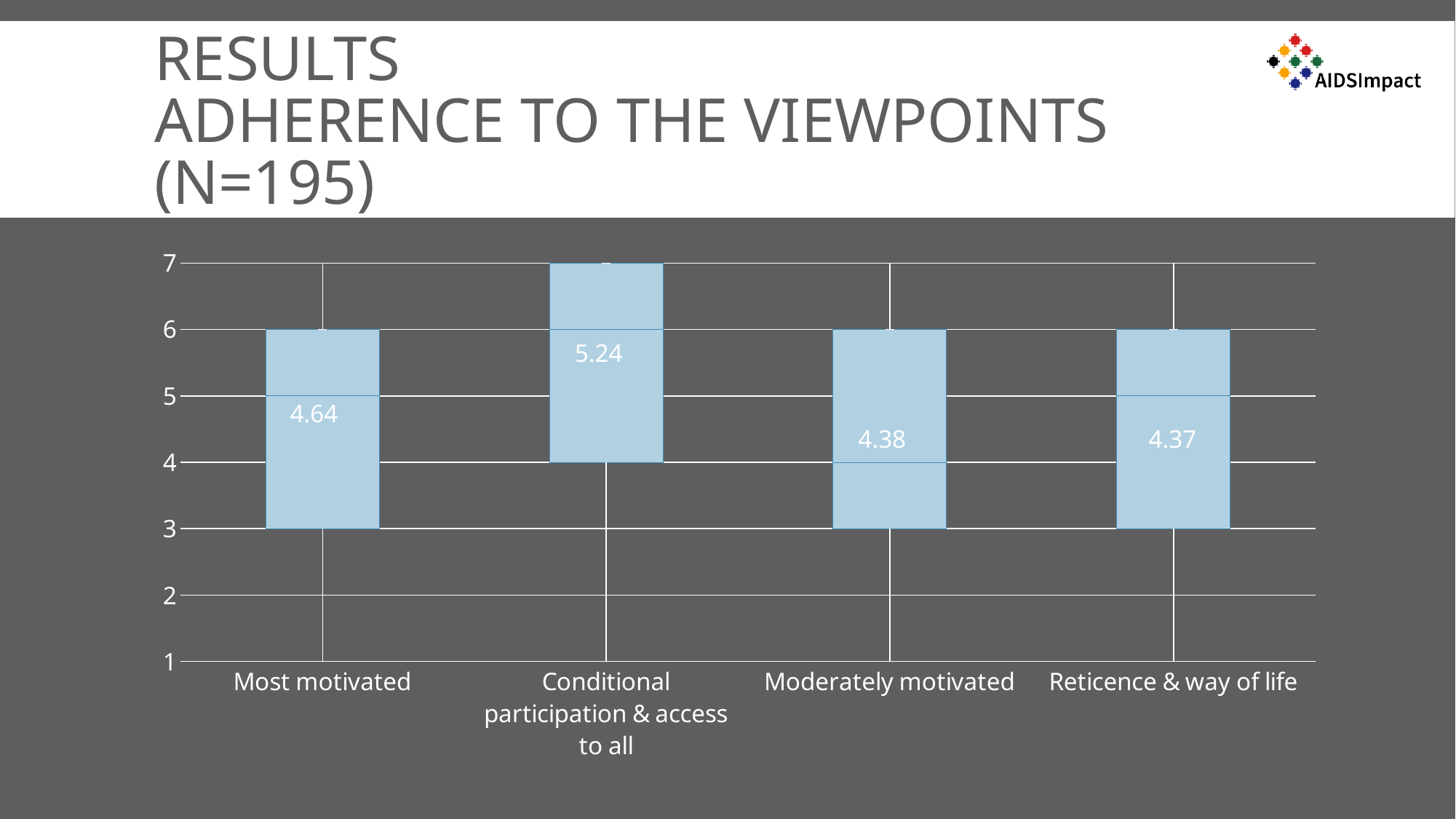
What is the highest value shown on the vertical axis? 7 Is the labelled value for Conditional participation & access to all greater or less than 5? greater Which category has the highest labelled value? Conditional participation & access to all What is the value labelled for Moderately motivated? 4.38 What is the difference between the labelled values for Conditional participation & access to all and Moderately motivated? 0.86 What is the value labelled for Conditional participation & access to all? 5.24 How many categories are shown on the x axis? 4 What is the difference between the labelled values for Conditional participation & access to all and Most motivated? 0.60 What is the value labelled for Most motivated? 4.64 What is the value labelled for Reticence & way of life? 4.37 Which category has the lowest labelled value? Reticence & way of life Which has the larger labelled value, Most motivated or Moderately motivated? Most motivated